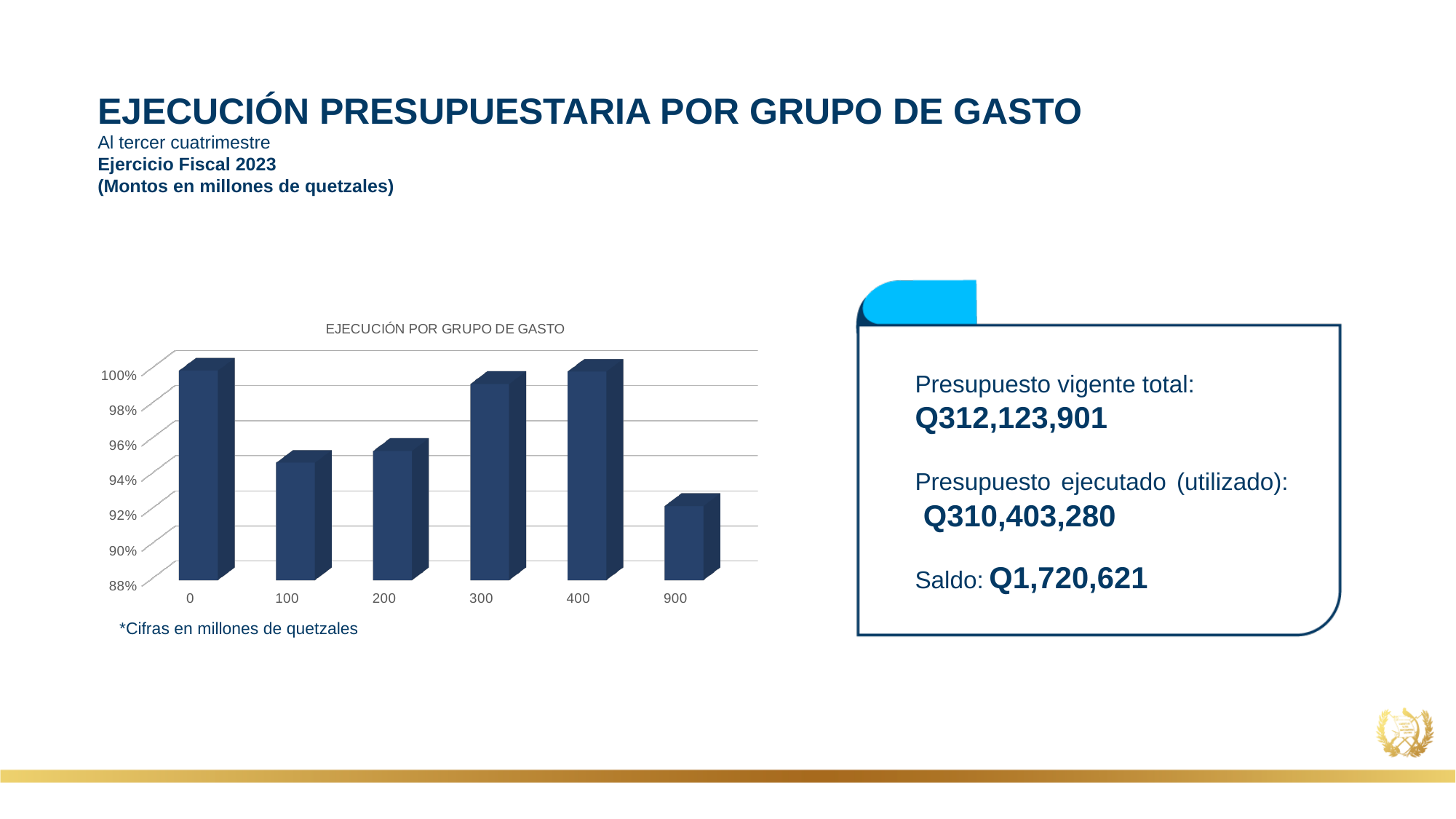
Which has a higher execution percentage, category 300 or category 900? 300 What is the lowest percentage shown on the chart's y axis? 88% Is the value for category 0 greater or less than 98%? greater How many categories (grupos de gasto) are shown on the x axis of the chart? 6 Is the value for category 100 greater or less than 92%? greater What kind of chart is shown on the slide? bar chart Which has a higher execution percentage, category 400 or category 100? 400 Is the value for category 200 greater or less than 98%? less What is the title of the chart? EJECUCIÓN POR GRUPO DE GASTO Which category has the lowest execution percentage in the chart? 900